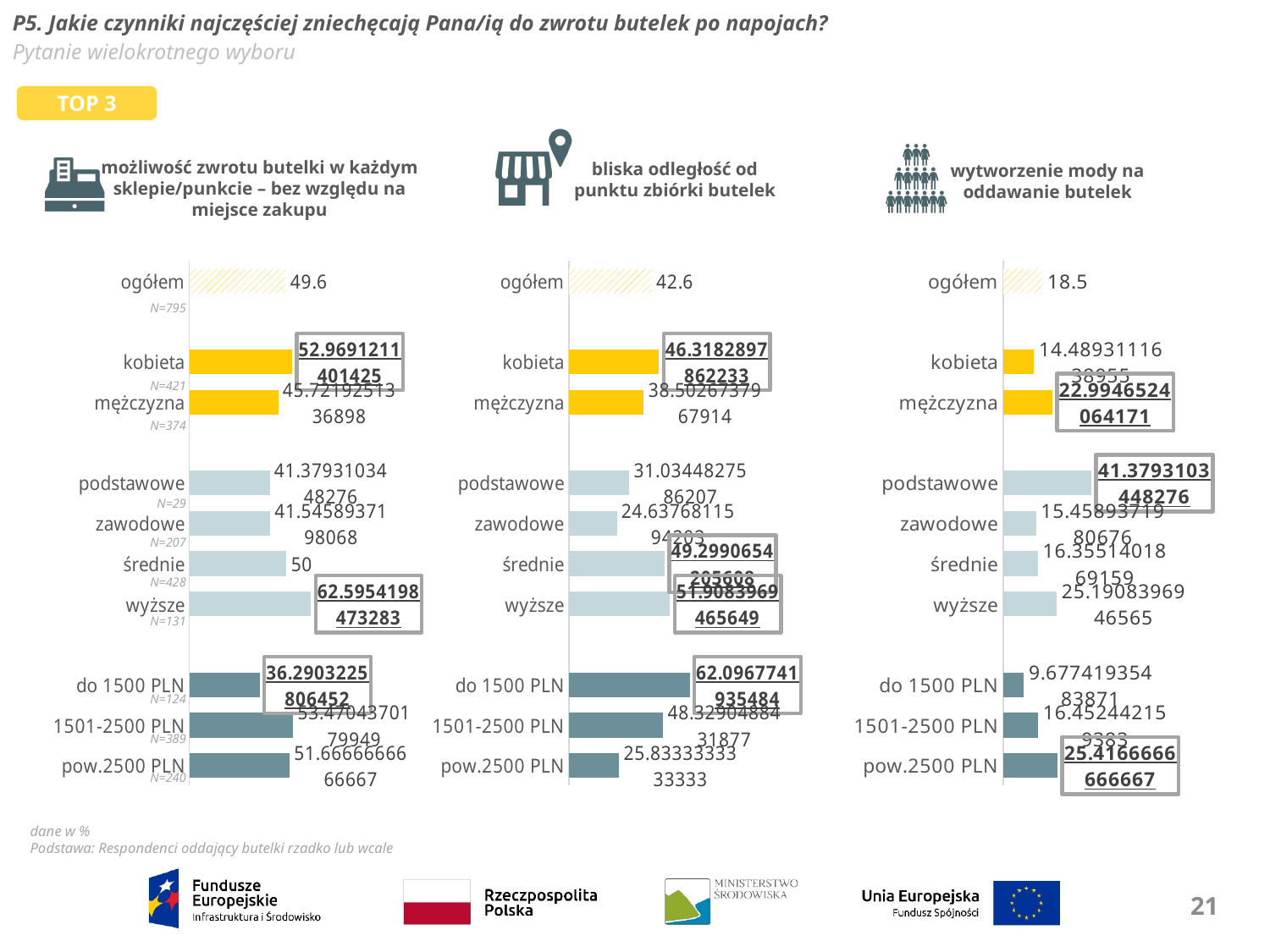
In the left chart (możliwość zwrotu butelki w każdym sklepie/punkcie), what is the value for ogółem? 49.6 In the middle chart (bliska odległość od punktu zbiórki butelek), which income category has the highest value? do 1500 PLN In the left chart (możliwość zwrotu butelki w każdym sklepie/punkcie), which education category has the highest value? wyższe What kind of chart is used on this slide? Bar chart In the right chart (wytworzenie mody na oddawanie butelek), which education category has the highest value? podstawowe In the right chart (wytworzenie mody na oddawanie butelek), what is the value for ogółem? 18.5 In the middle chart (bliska odległość od punktu zbiórki butelek), which is larger, the value for kobieta or for mężczyzna? kobieta In the right chart (wytworzenie mody na oddawanie butelek), which income category has the lowest value? do 1500 PLN In the middle chart (bliska odległość od punktu zbiórki butelek), what is the value for ogółem? 42.6 In the left chart (możliwość zwrotu butelki w każdym sklepie/punkcie), what is the value for średnie? 50 In the right chart (wytworzenie mody na oddawanie butelek), which is larger, the value for kobieta or for mężczyzna? mężczyzna How many categories (bars) are plotted in the left chart (możliwość zwrotu butelki w każdym sklepie/punkcie)? 10